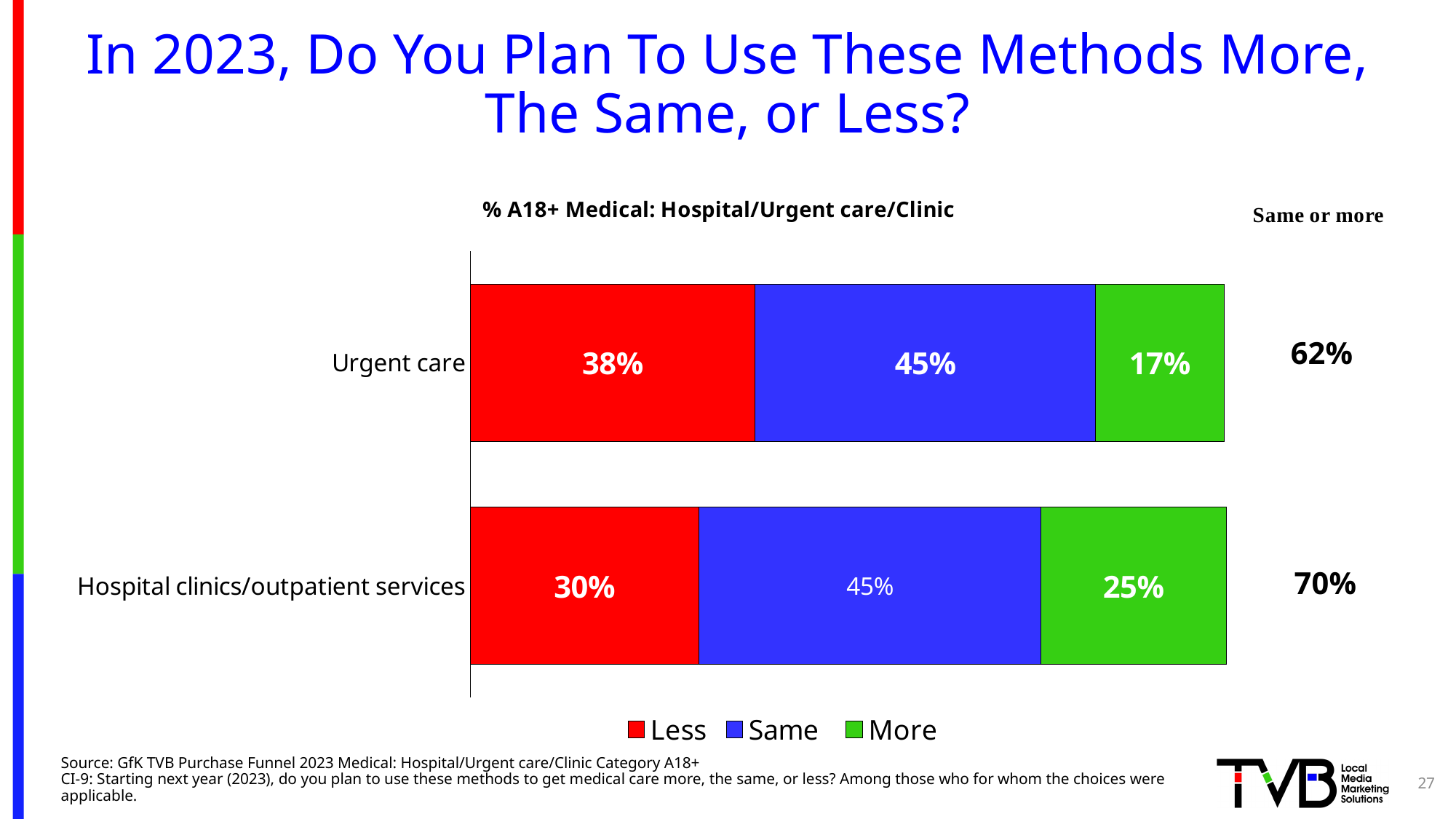
Which category has the higher 'More' value? Hospital clinics/outpatient services What is the 'Same' value for hospital clinics/outpatient services? 45% What is the difference between the 'Less' values for urgent care and hospital clinics/outpatient services? 8% What percentage of respondents plan to use hospital clinics/outpatient services more? 25% Which colour represents the 'Same' series in the chart? Blue Which category has the lower 'Less' value? Hospital clinics/outpatient services How many categories are shown in the chart? 2 What percentage of respondents plan to use urgent care less? 38% Is the 'More' value larger for urgent care or for hospital clinics/outpatient services? Hospital clinics/outpatient services What is the 'Same or more' figure shown for urgent care? 62% How many series does the legend list? 3 What kind of chart is shown on the slide? Stacked bar chart